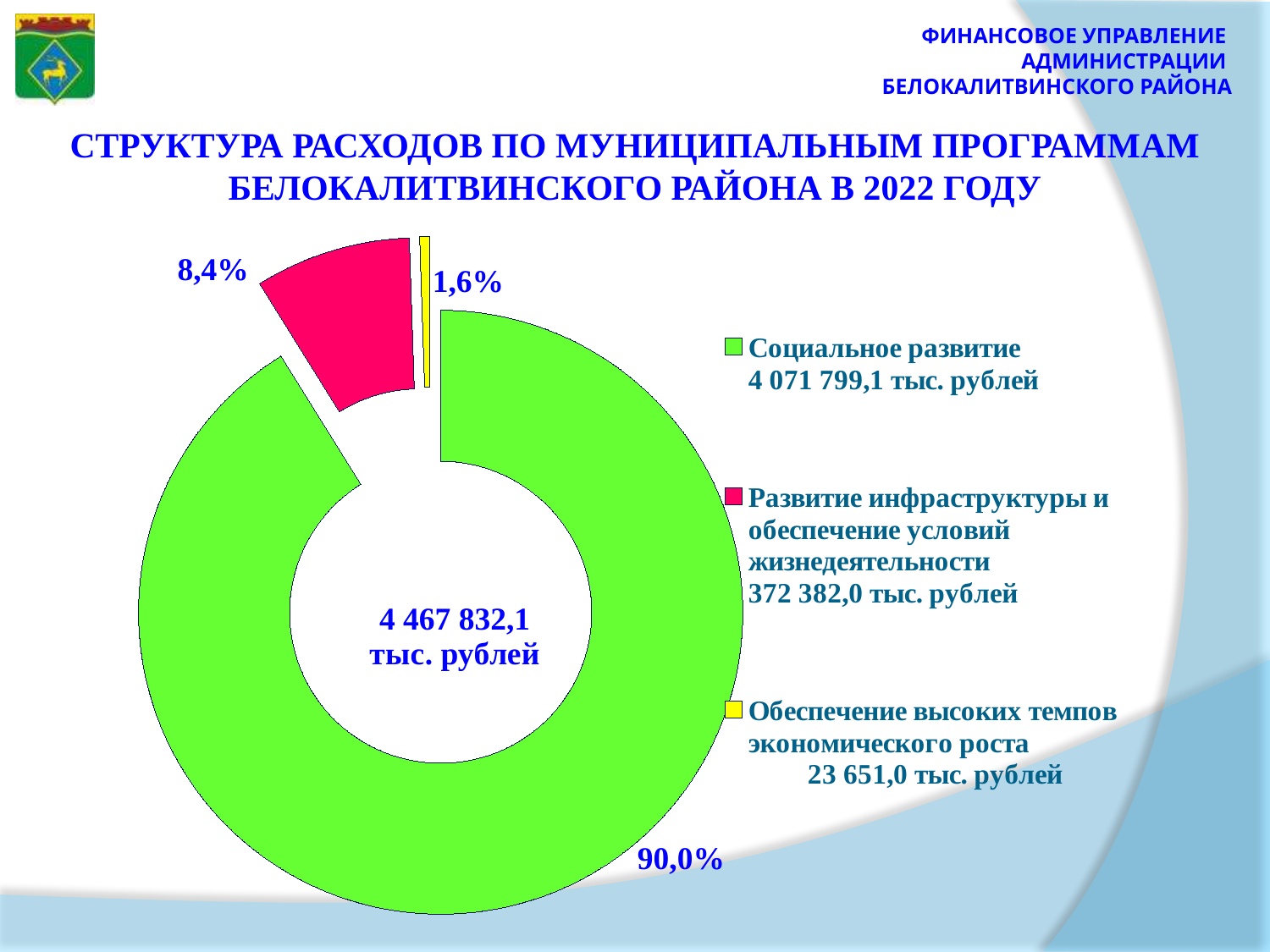
Which category has the largest share of expenditures? Социальное развитие What share of expenditures does «Обеспечение высоких темпов экономического роста» account for? 1,6% What is the total of expenditures shown in the centre of the chart? 4 467 832,1 тыс. рублей What share of expenditures does «Развитие инфраструктуры и обеспечение условий жизнедеятельности» account for? 8,4% What share of expenditures does «Социальное развитие» account for? 90,0% How many categories does the chart show? 3 What is the value for «Развитие инфраструктуры и обеспечение условий жизнедеятельности»? 372 382,0 тыс. рублей What type of chart is shown on the slide? doughnut chart What is the value for «Обеспечение высоких темпов экономического роста»? 23 651,0 тыс. рублей Which category has the smallest share of expenditures? Обеспечение высоких темпов экономического роста What is the difference in value between «Развитие инфраструктуры и обеспечение условий жизнедеятельности» and «Обеспечение высоких темпов экономического роста»? 348 731,0 тыс. рублей What is the value for «Социальное развитие»? 4 071 799,1 тыс. рублей